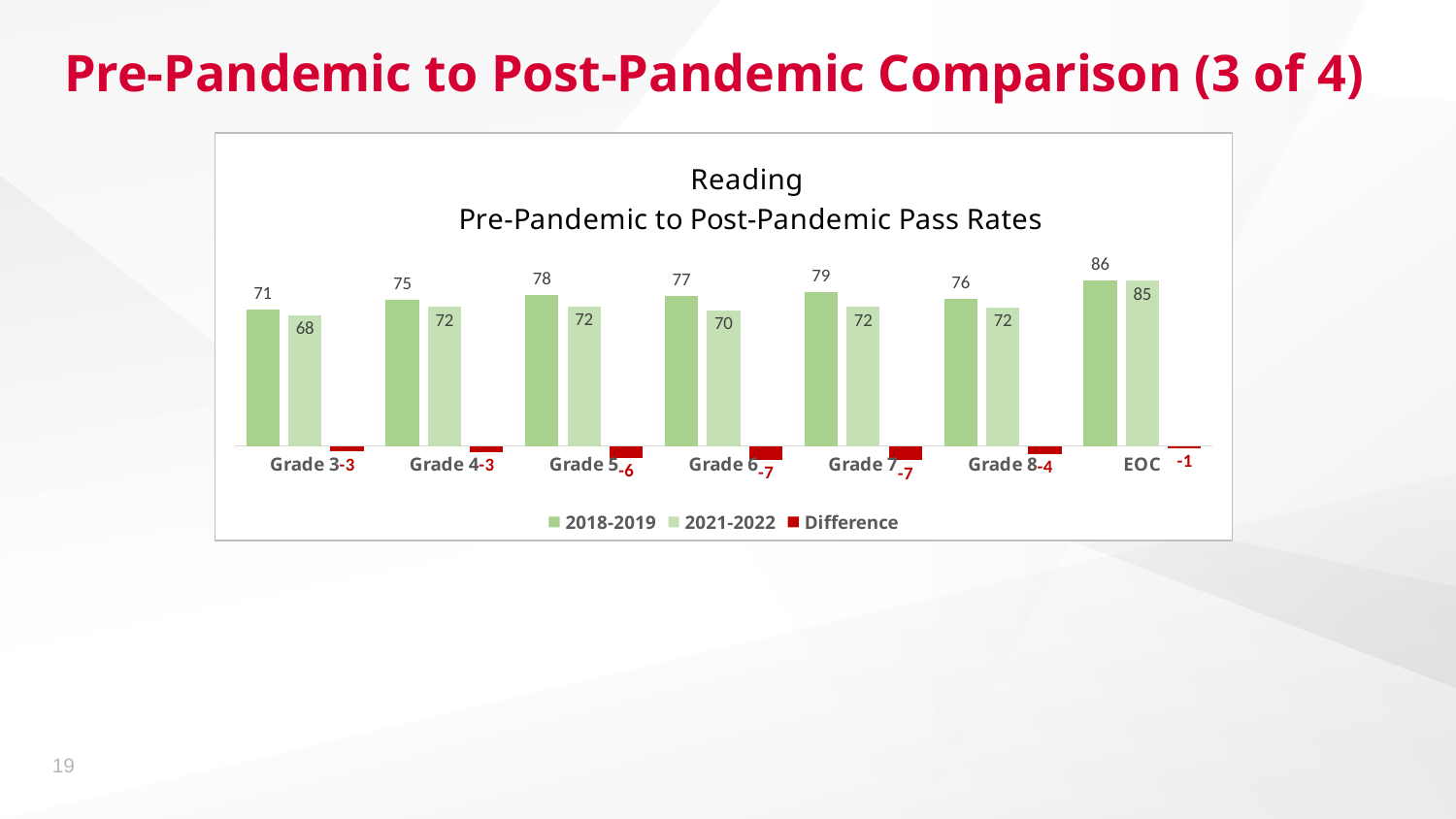
What is the title of the chart? Reading Pre-Pandemic to Post-Pandemic Pass Rates What is the 2021-2022 pass rate for Grade 6? 70 Which category has the lowest 2021-2022 pass rate? Grade 3 What kind of chart is shown? Bar chart Which is larger, the 2018-2019 pass rate for Grade 4 or the 2018-2019 pass rate for Grade 7? Grade 7 What is the Difference value shown for Grade 7? -7 Which series is shown in red in the legend? Difference How many series does the legend list? 3 How many categories are shown on the x axis? 7 Which category has the highest 2018-2019 pass rate? EOC What is the 2018-2019 pass rate for Grade 5? 78 What is the difference between the 2018-2019 and 2021-2022 pass rates for Grade 8? 4